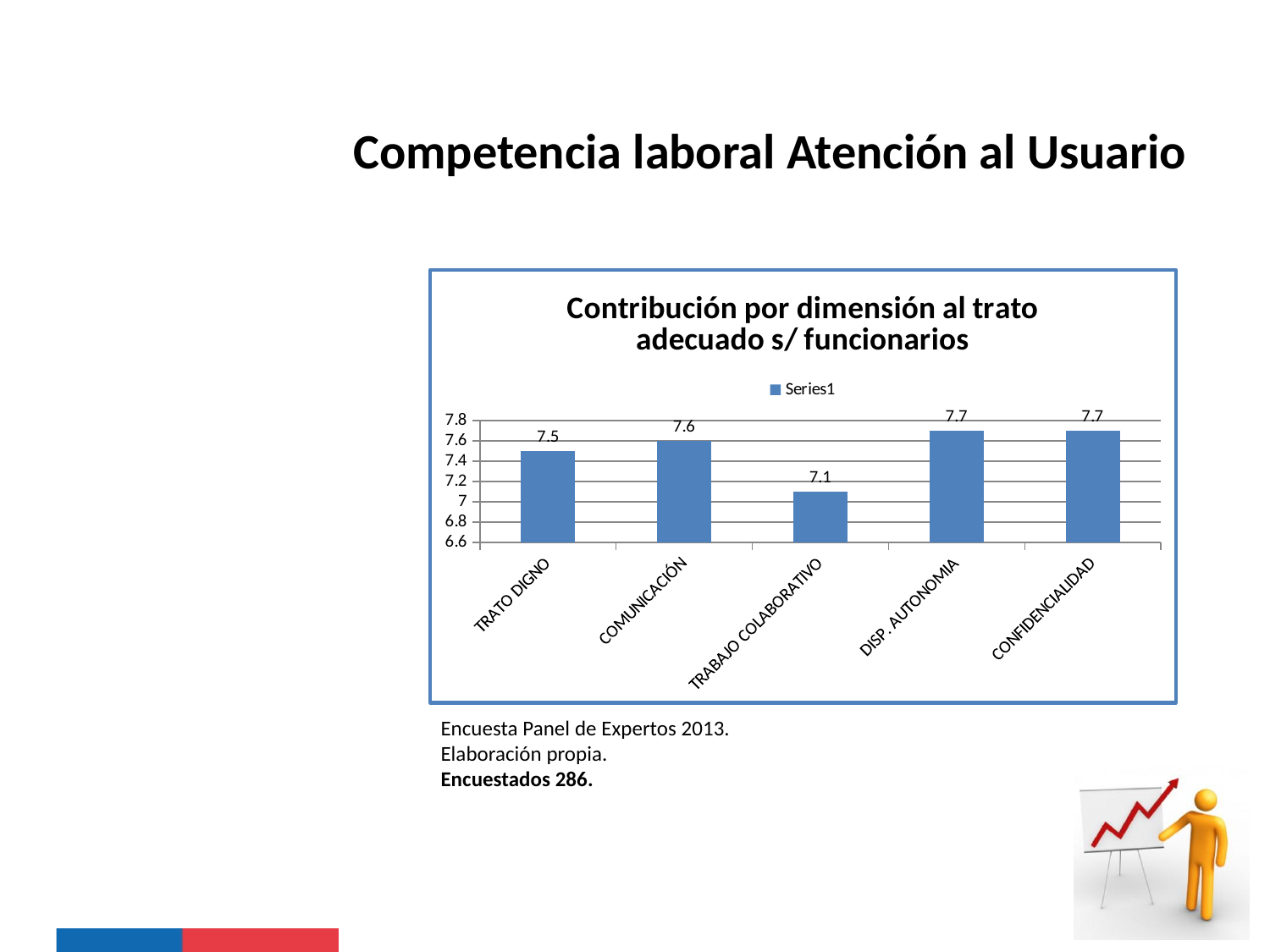
Which is larger, the value for TRATO DIGNO or the value for DISP. AUTONOMIA? DISP. AUTONOMIA What is the value for COMUNICACIÓN? 7.6 What is the value for DISP. AUTONOMIA? 7.7 What is the value for TRATO DIGNO? 7.5 Which category has the lowest value? TRABAJO COLABORATIVO What is the value for TRABAJO COLABORATIVO? 7.1 Is the value for TRABAJO COLABORATIVO greater or less than 7.2? less What is the value for CONFIDENCIALIDAD? 7.7 What is the title of the chart? Contribución por dimensión al trato adecuado s/ funcionarios What kind of chart is shown? bar chart How many categories are shown on the x axis? 5 What is the difference between the values for COMUNICACIÓN and TRABAJO COLABORATIVO? 0.5